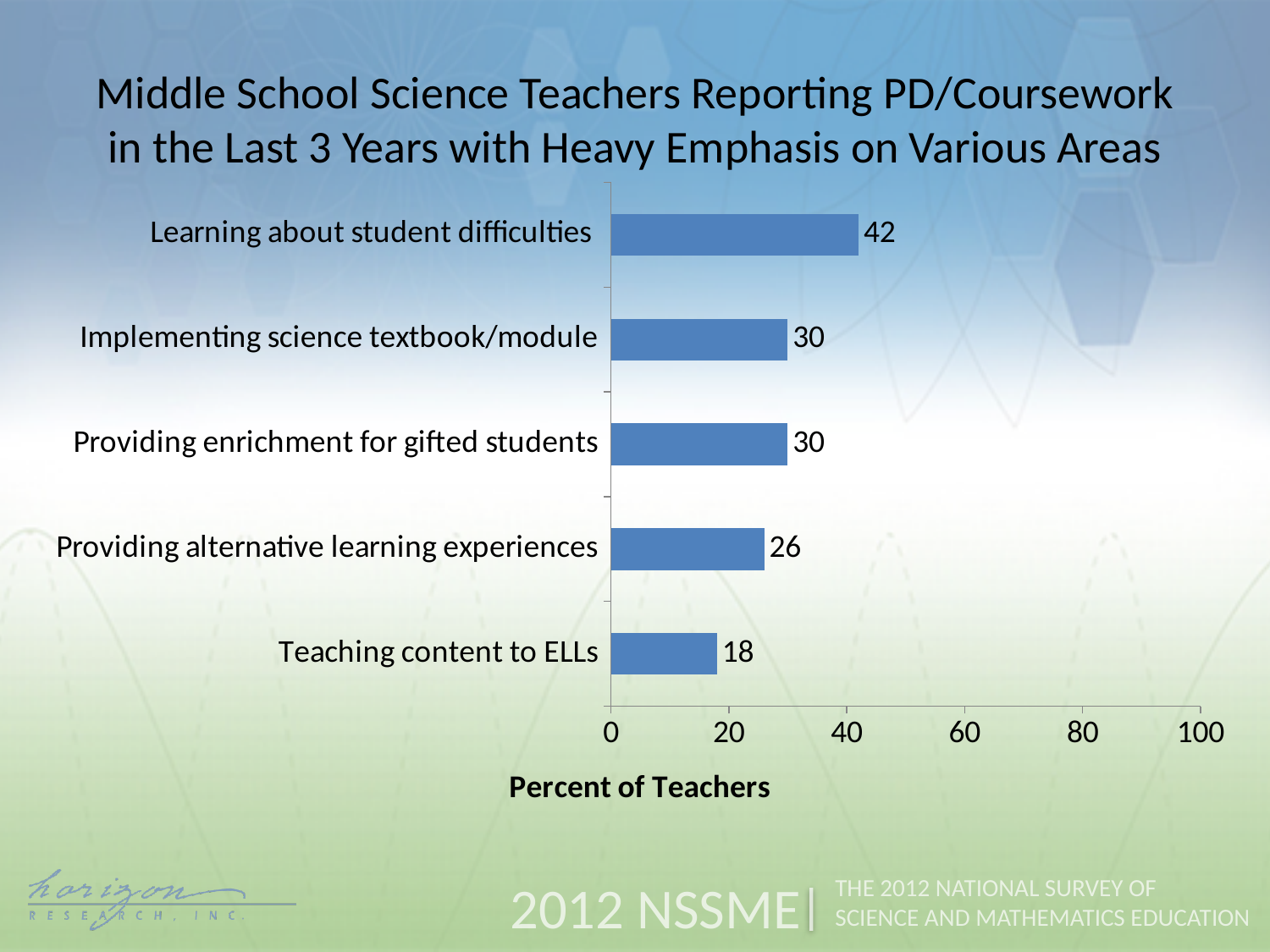
What percent of teachers reported heavy emphasis on learning about student difficulties? 42 Which is larger: the value for providing enrichment for gifted students or providing alternative learning experiences? Providing enrichment for gifted students What kind of chart is shown on the slide? Bar chart Is the value for learning about student difficulties greater or less than 40? greater How many areas are shown in the chart? 5 What is the value for implementing science textbook/module? 30 What is the label of the horizontal axis? Percent of Teachers Which area has the highest percent of teachers? Learning about student difficulties What is the difference between the values for learning about student difficulties and teaching content to ELLs? 24 What is the value for teaching content to ELLs? 18 What is the value for providing alternative learning experiences? 26 Which area has the lowest percent of teachers? Teaching content to ELLs